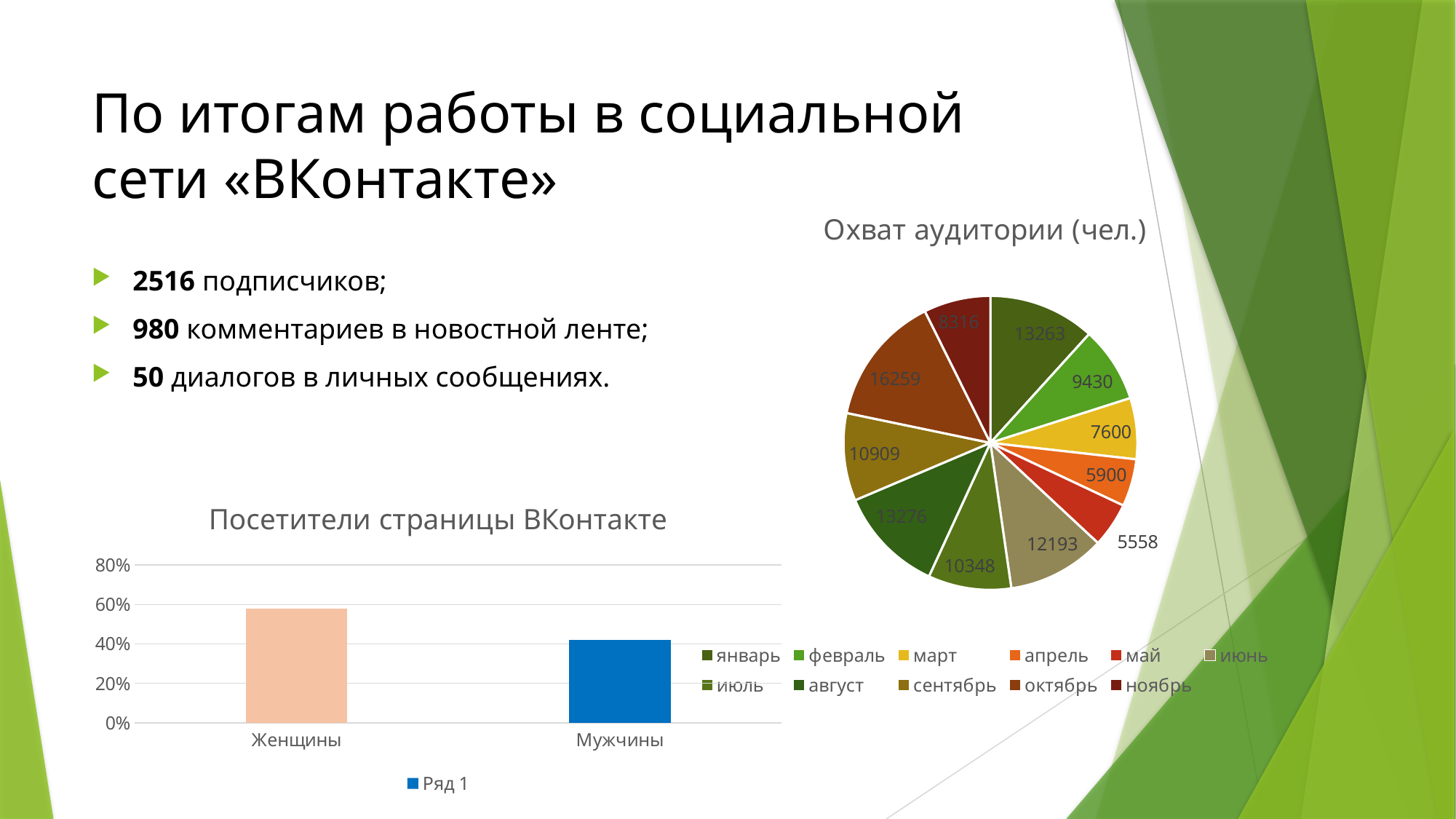
On the chart titled "Охват аудитории (чел.)", which month has the largest value? октябрь On the chart titled "Охват аудитории (чел.)", what is the value for январь? 13263 On the chart titled "Охват аудитории (чел.)", how many slices does the pie have? 11 On the chart titled "Охват аудитории (чел.)", what is the difference between the values for октябрь and май? 10701 On the chart titled "Охват аудитории (чел.)", which month has the smallest value? май On the chart titled "Охват аудитории (чел.)", what is the value for июнь? 12193 On the chart titled "Охват аудитории (чел.)", which is larger, the value for февраль or the value for апрель? февраль What kind of chart is the chart titled "Охват аудитории (чел.)"? pie chart On the chart titled "Охват аудитории (чел.)", what is the value for октябрь? 16259 On the chart titled "Посетители страницы ВКонтакте", which is larger, the value for Женщины or the value for Мужчины? Женщины On the chart titled "Посетители страницы ВКонтакте", how many series does the legend list? 1 On the chart titled "Посетители страницы ВКонтакте", is the value for Женщины greater or less than 40%? greater